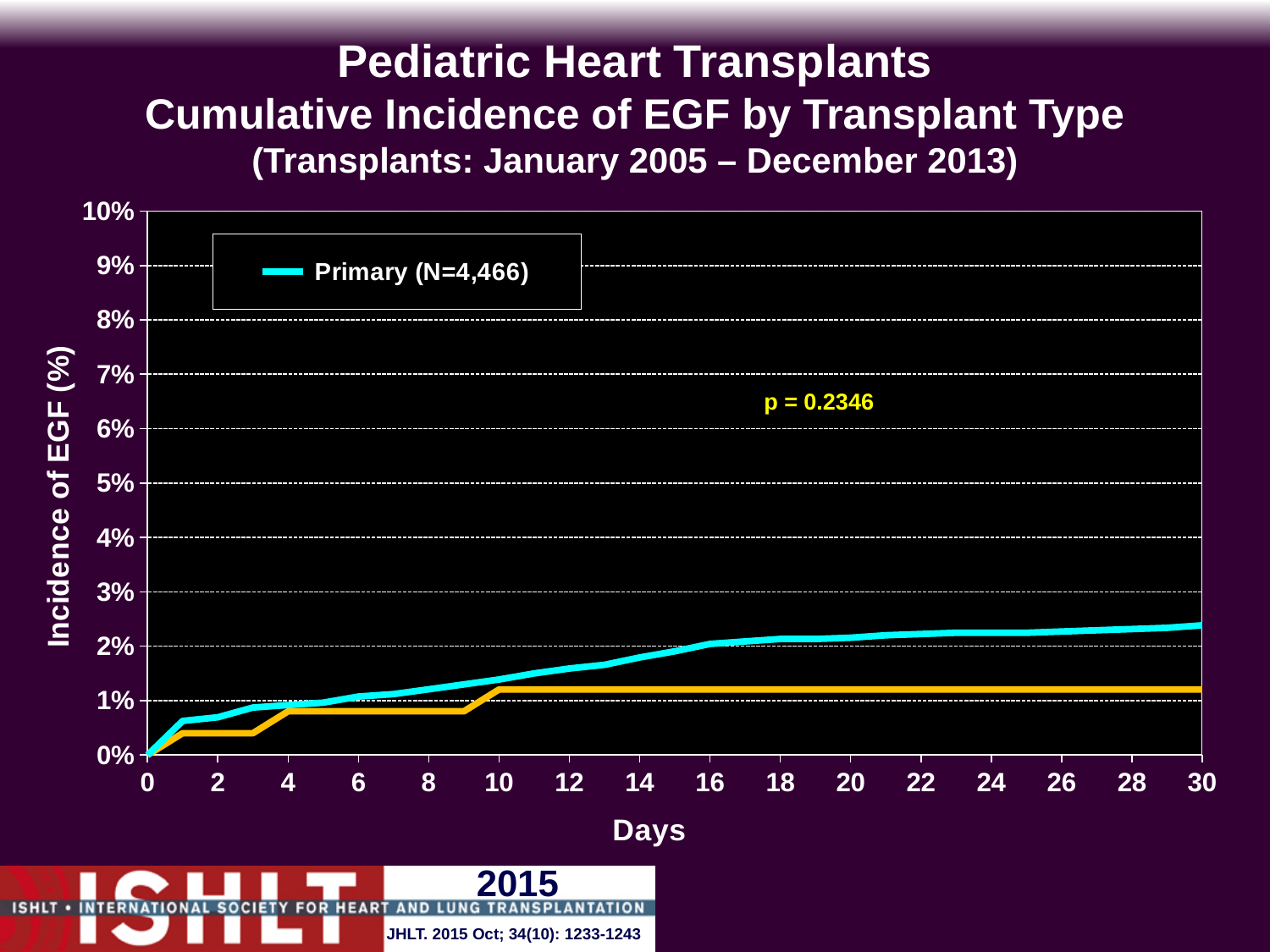
Is the value of the yellow line at day 30 greater or less than 2%? less What kind of chart is shown on the slide? line chart Is the value for the Primary series at day 10 greater or less than 2%? less At day 30, which line is higher, the cyan line or the yellow line? cyan Does the cumulative incidence for the Primary series rise or fall as days increase? rise What p-value is printed on the chart? p = 0.2346 What is the value for the Primary series at day 0? 0% What is the highest value shown on the y axis? 10% Is the value for the Primary series at day 10 greater or less than 1%? greater How many series does the legend list? 1 What is the legend entry for the cyan line? Primary (N=4,466)